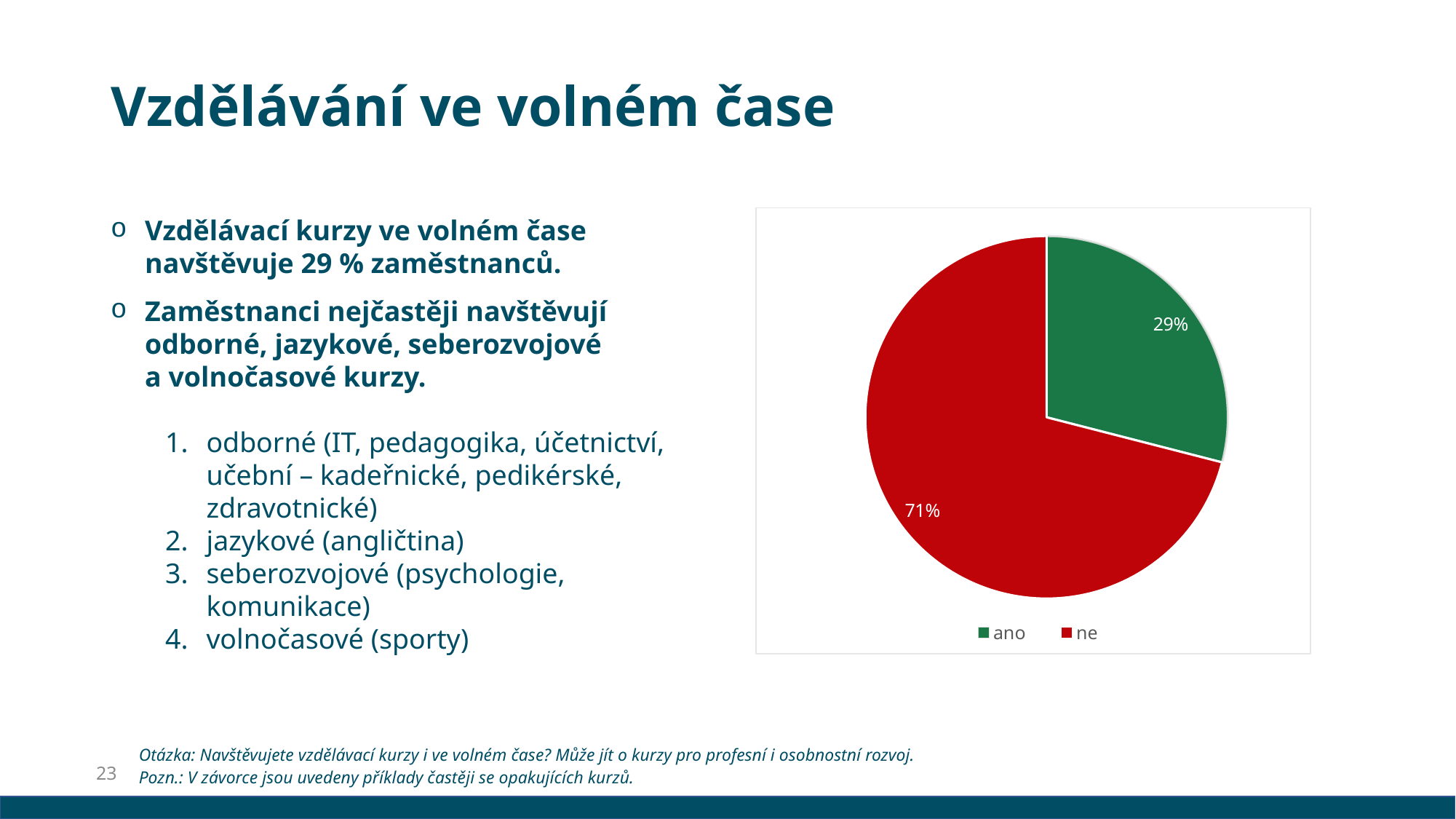
What share of the pie does the "ano" slice represent? 29% What share of the pie does the "ne" slice represent? 71% What colour is the "ano" slice? green Which slice of the pie is the largest? ne What is the total of the two slices shown in the pie chart? 100% What kind of chart is shown on the slide? pie chart How many slices does the pie chart have? 2 How many entries does the legend list? 2 What is the difference in percentage points between the "ne" and "ano" slices? 42 Which is larger, the "ano" slice or the "ne" slice? ne Which slice of the pie is the smallest? ano What colour is the "ne" slice? red